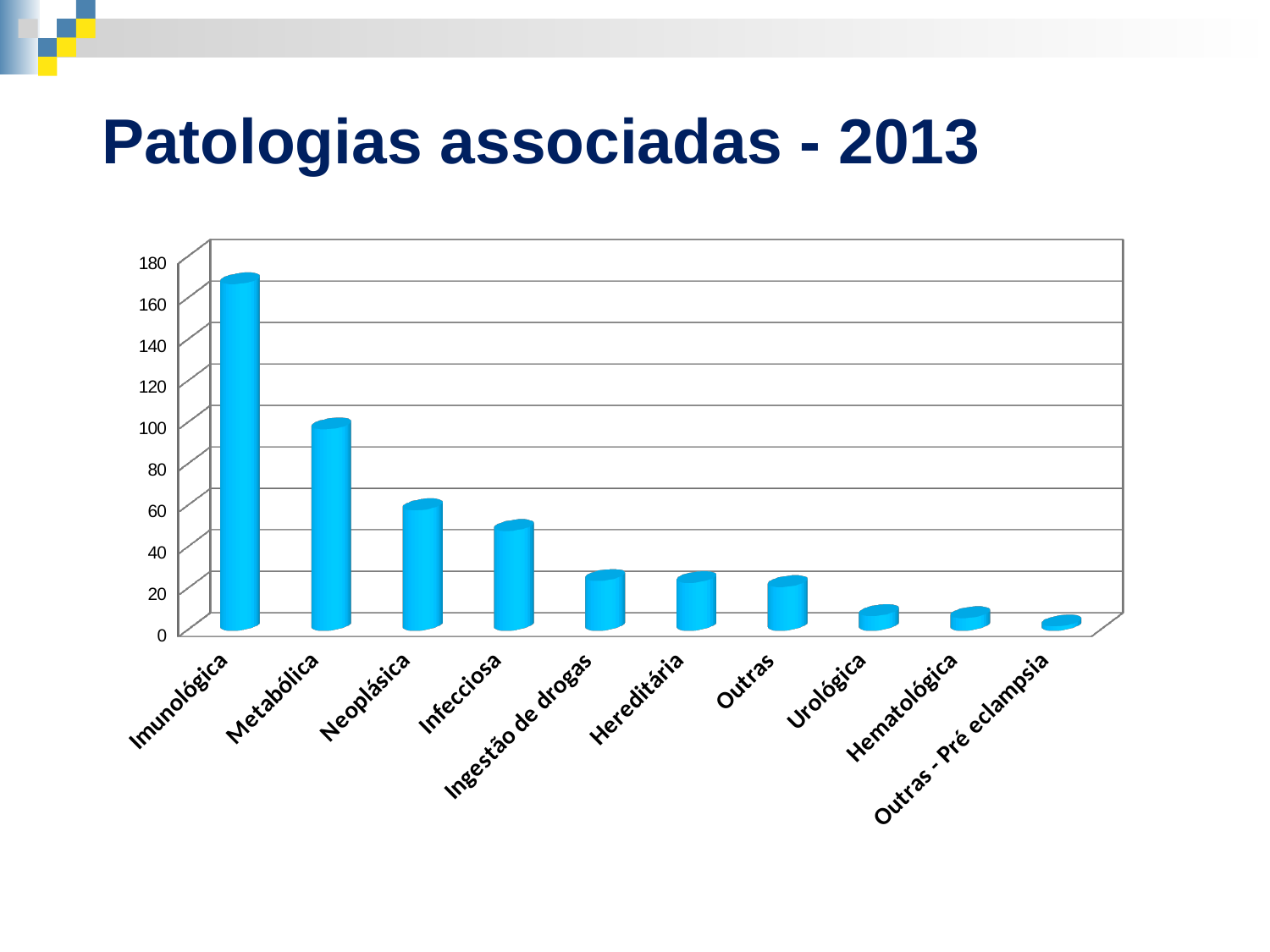
Which category has the highest value? Imunológica How many categories are shown on the x axis of the chart? 10 Which is larger, the value for Metabólica or the value for Neoplásica? Metabólica Is the value for Metabólica greater or less than 120? less Is the value for Neoplásica greater or less than 40? greater Is the value for Urológica greater or less than 20? less Do the values generally rise or fall moving from left to right along the x axis? Fall Which is larger, the value for Infecciosa or the value for Outras? Infecciosa What kind of chart is shown on the slide? Bar chart What is the title of the slide? Patologias associadas - 2013 Which category has the lowest value? Outras - Pré eclampsia